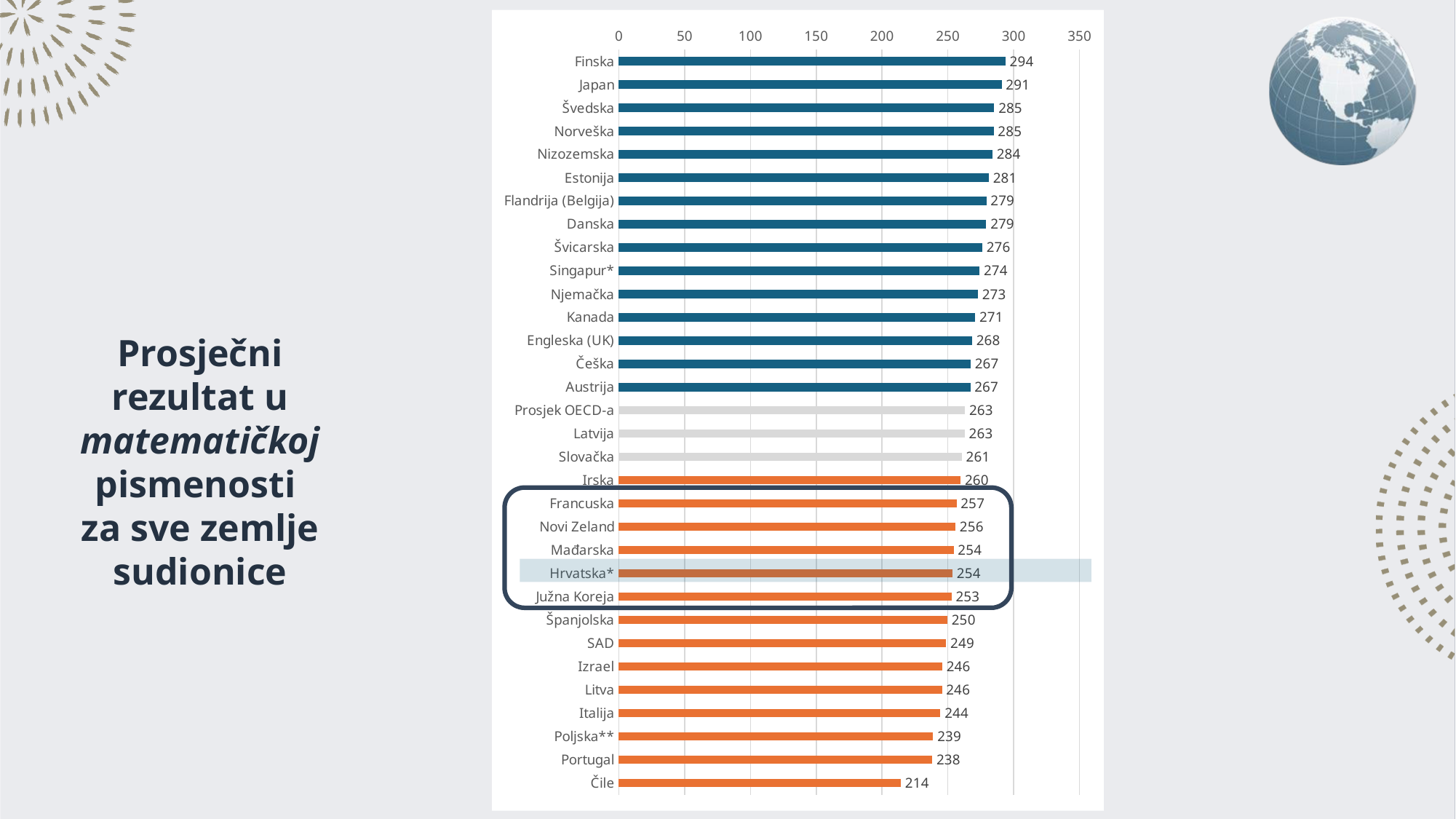
Which has a larger value, Estonija or Kanada? Estonija What is the value for Prosjek OECD-a? 263 What colour are the bars for Prosjek OECD-a, Latvija and Slovačka? grey Which country has the highest value? Finska Is the value for Portugal greater or less than 250? less What is the difference between the values for Prosjek OECD-a and Hrvatska*? 9 What is the difference between the values for Finska and Čile? 80 What is the value for Japan? 291 What kind of chart is shown on the slide? bar chart How many bars are shown in the chart? 32 What is the value for Hrvatska*? 254 Which country has the lowest value? Čile